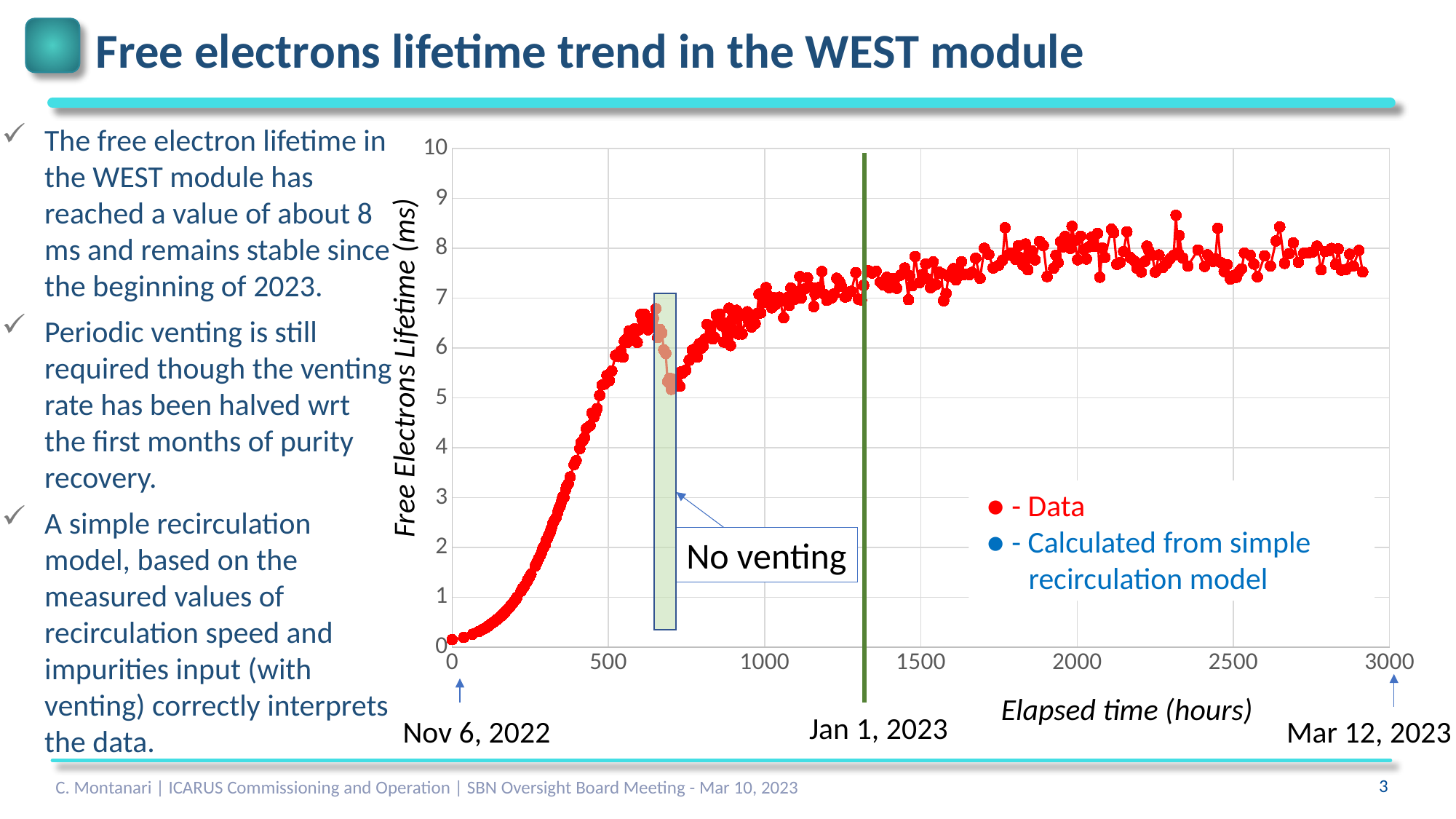
Is the free electron lifetime at 2000 hours greater or less than 7 ms? greater What is the highest value shown on the y axis of the chart? 10 Which is larger, the free electron lifetime at 300 hours or at 1500 hours? 1500 hours Is the free electron lifetime at 0 hours greater or less than 1 ms? less Is the free electron lifetime at 500 hours greater or less than 4 ms? greater What kind of chart is shown on the slide? scatter chart What label is given to the shaded region around 650-700 hours on the chart? No venting Does the free electron lifetime rise or fall as elapsed time increases from 0 to 1000 hours? rise How many series does the chart legend list? 2